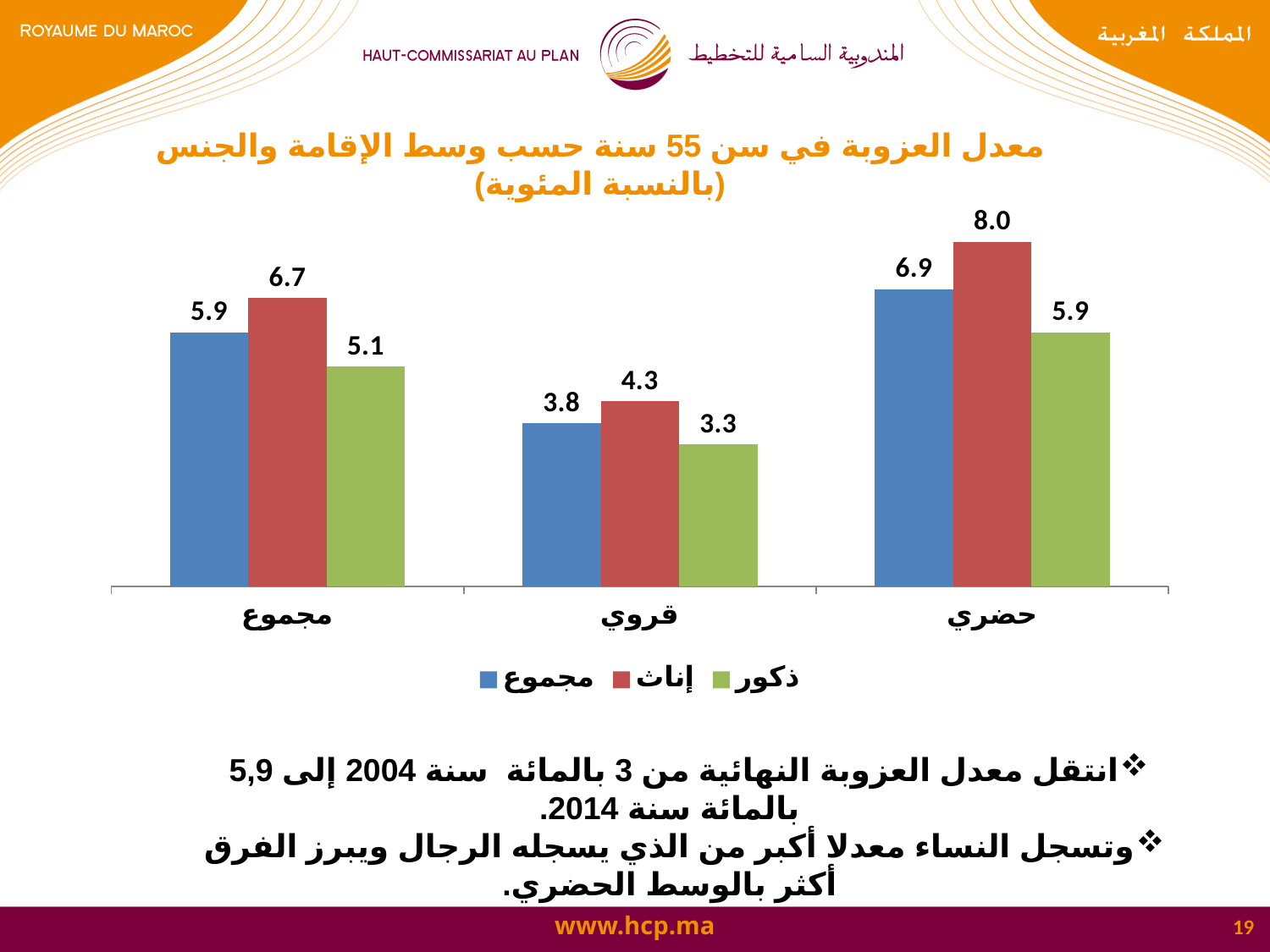
Which is larger: the إناث value in قروي or the ذكور value in مجموع? ذكور value in مجموع What is the difference between the إناث and ذكور values in the حضري category? 2.1 What is the value for ذكور in the قروي category? 3.3 Which category has the highest value for إناث? حضري What is the value for إناث in the حضري category? 8.0 What kind of chart is shown on the slide? bar chart Which category has the lowest value for ذكور? قروي How many series does the legend list? 3 What is the value for مجموع in the مجموع category? 5.9 What is the difference between the حضري and قروي values for مجموع? 3.1 Which colour represents the إناث series? red How many categories are shown on the x axis? 3